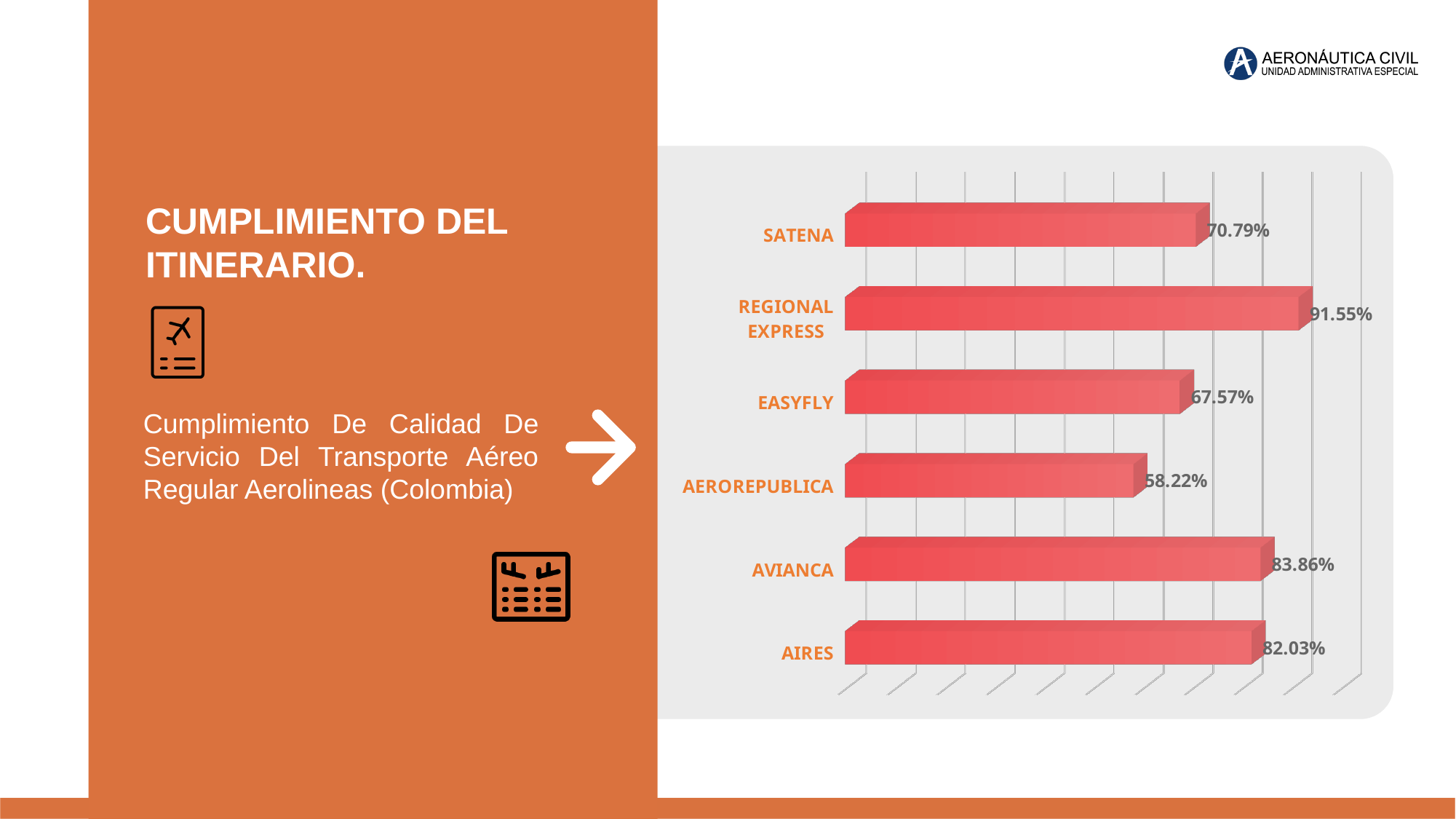
What kind of chart is shown on the slide? Bar chart What is the value shown for AIRES? 82.03% Which airline has the lowest value in the chart? AEROREPUBLICA What is the difference between the values for REGIONAL EXPRESS and AEROREPUBLICA? 33.33% What is the value shown for SATENA? 70.79% What is the value shown for AVIANCA? 83.86% Which has a larger value, REGIONAL EXPRESS or AVIANCA? REGIONAL EXPRESS What is the value shown for AEROREPUBLICA? 58.22% How many airlines are shown in the chart? 6 What is the difference between the values for AVIANCA and AIRES? 1.83% Which airline has the highest value in the chart? REGIONAL EXPRESS What is the value shown for REGIONAL EXPRESS? 91.55%